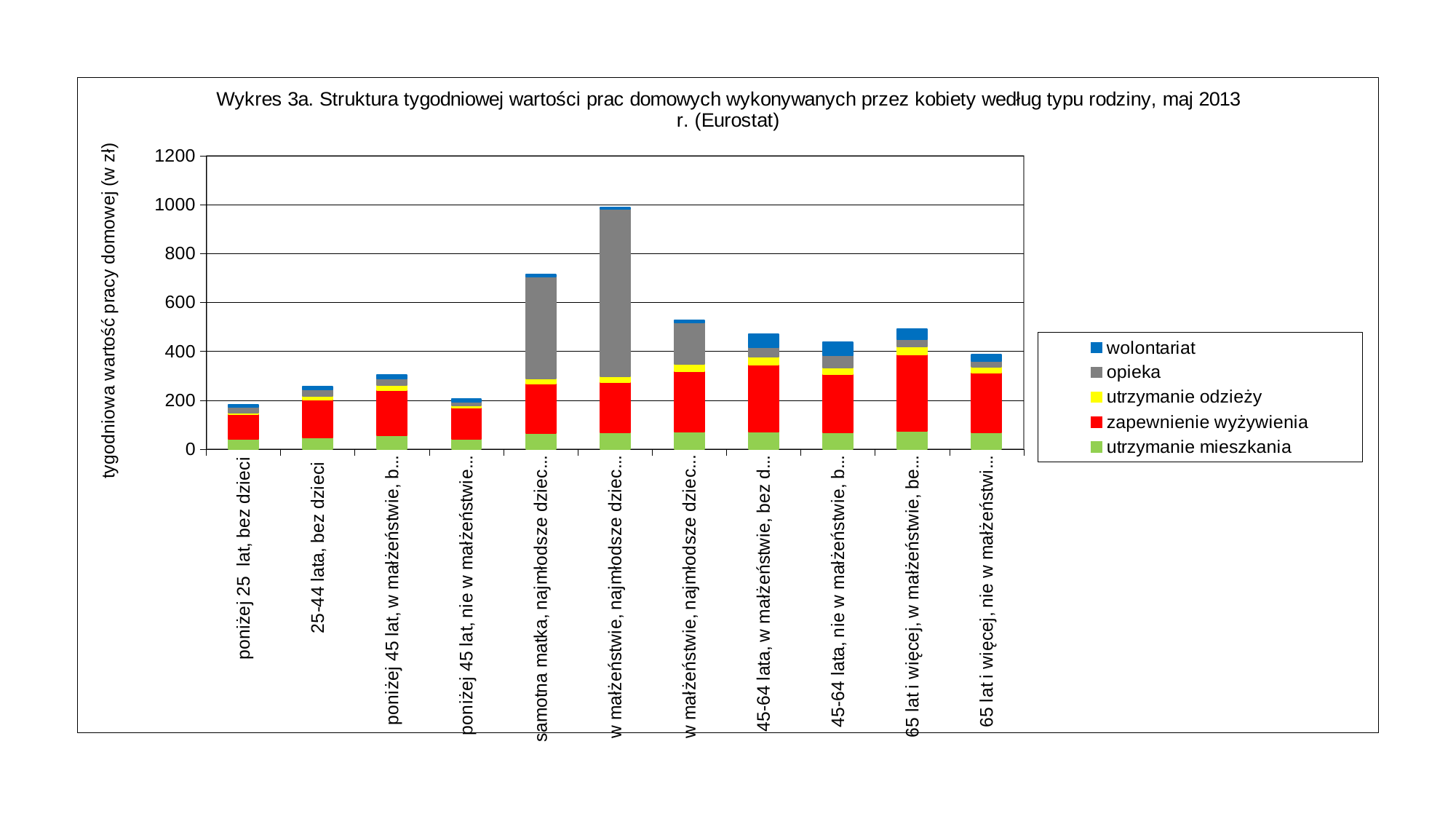
Is the total value for the tallest bar (sixth from the left) greater or less than 800? greater How many family-type categories are plotted along the x axis? 11 Which series is shown in blue in the legend? wolontariat What kind of chart is shown on the slide? stacked bar chart Which has a larger total value: 'poniżej 25 lat, bez dzieci' or '25-44 lata, bez dzieci'? 25-44 lata, bez dzieci Which series makes up the largest part of the tallest bar (sixth from the left)? opieka How many series does the legend list? 5 Is the total value for '25-44 lata, bez dzieci' greater or less than 200? greater What is the label of the y axis? tygodniowa wartość pracy domowej (w zł) Is the total value for the fifth bar from the left (samotna matka, najmłodsze dziec...) greater or less than 600? greater Which bar has the highest total value? the sixth bar from the left (w małżeństwie, najmłodsze dziec...)